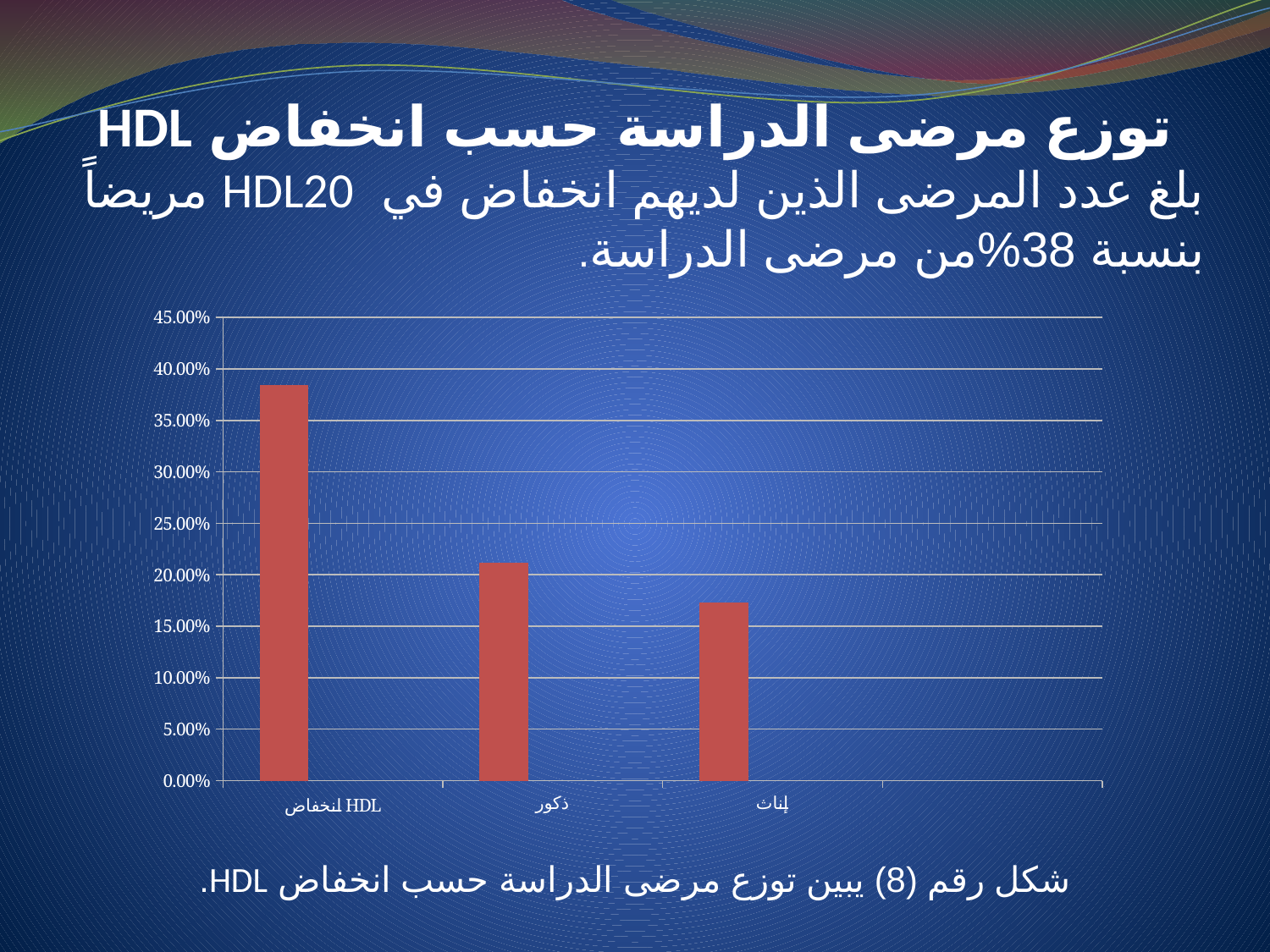
Which category has the lowest bar in the chart? إناث Is the value for انخفاض HDL greater or less than 40.00%? less Is the value for إناث greater or less than 15.00%? greater Do the bar values rise or fall from left to right along the x axis? fall What is the highest value shown on the y axis of the chart? 45.00% Is the value for ذكور greater or less than 25.00%? less Which category has the highest bar in the chart? انخفاض HDL Which is larger, the value for انخفاض HDL or the value for ذكور? انخفاض HDL How many categories are plotted on the x axis of the chart? 3 Which is larger, the value for ذكور or the value for إناث? ذكور What kind of chart is shown on the slide? bar chart